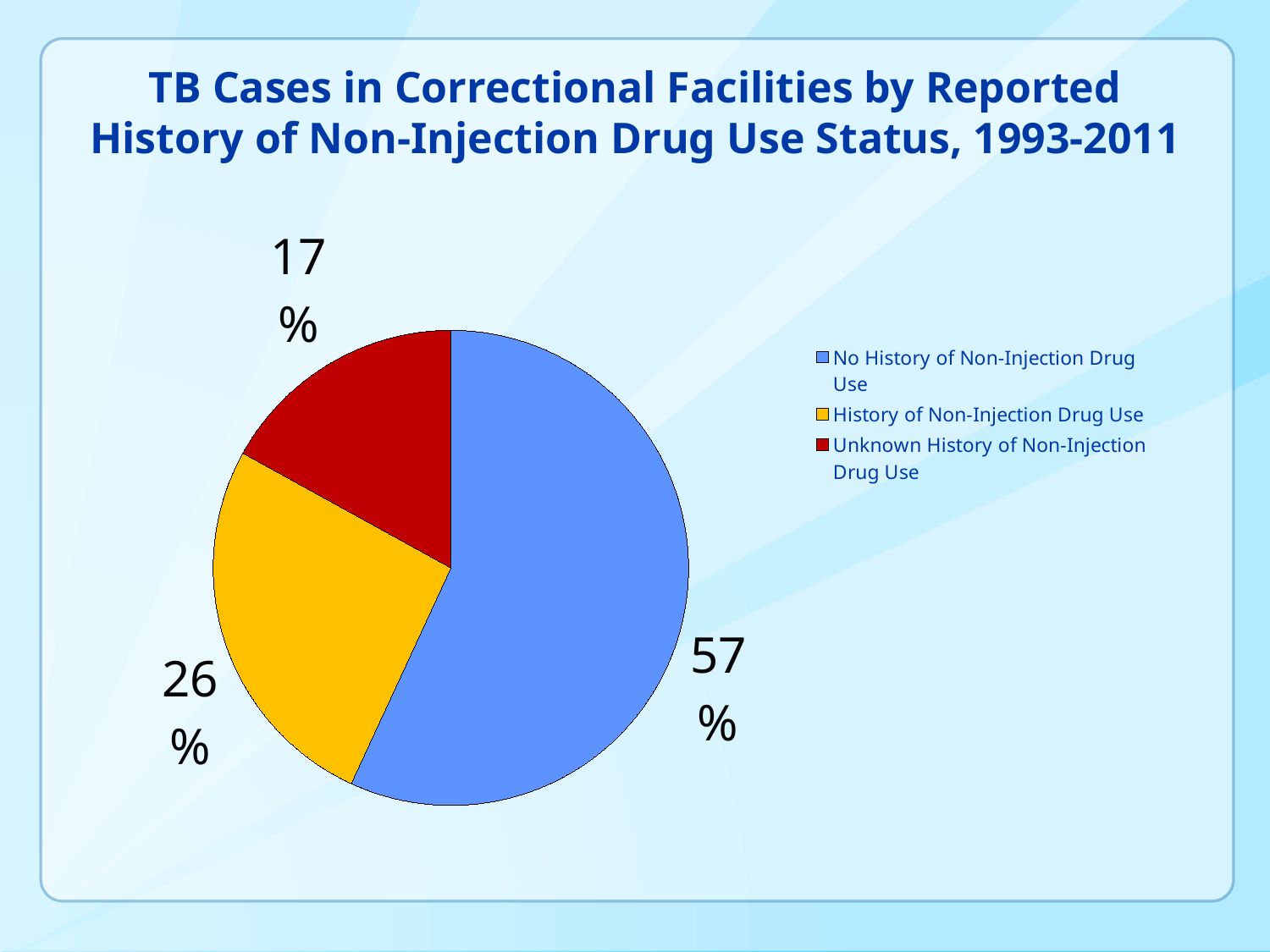
Which is larger: the share with a history of non-injection drug use or the share with an unknown history? History of Non-Injection Drug Use What colour is the slice for Unknown History of Non-Injection Drug Use? red How many categories does the pie chart have? 3 How many percentage points larger is the No History of Non-Injection Drug Use slice than the History of Non-Injection Drug Use slice? 31 What is the title of the chart? TB Cases in Correctional Facilities by Reported History of Non-Injection Drug Use Status, 1993-2011 How many percentage points larger is the History of Non-Injection Drug Use slice than the Unknown History of Non-Injection Drug Use slice? 9 What kind of chart is shown on the slide? pie chart What share of TB cases had a history of non-injection drug use? 26% What share of TB cases had an unknown history of non-injection drug use? 17% What share of TB cases had no history of non-injection drug use? 57% Which category has the largest slice of the pie? No History of Non-Injection Drug Use Which category has the smallest slice of the pie? Unknown History of Non-Injection Drug Use